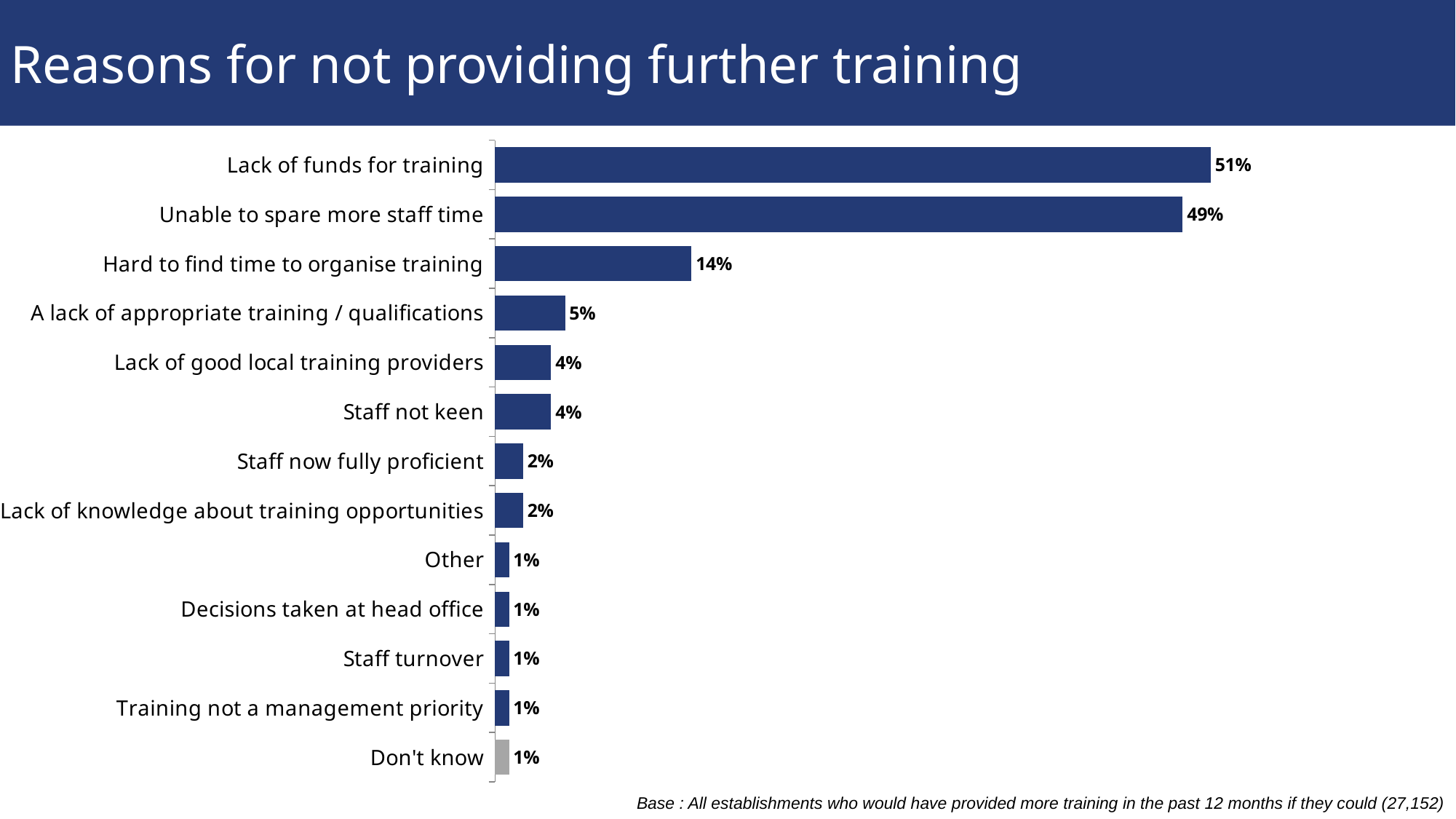
What is the value for Hard to find time to organise training? 14% Which is larger, A lack of appropriate training / qualifications or Lack of good local training providers? A lack of appropriate training / qualifications Which bar is shown in grey rather than dark blue? Don't know What is the title of the slide? Reasons for not providing further training What is the value for Staff not keen? 4% What is the difference between Lack of funds for training and Unable to spare more staff time? 2% What is the difference between Unable to spare more staff time and Hard to find time to organise training? 35% How many reasons are listed in the chart? 13 Which reason has the highest value? Lack of funds for training What kind of chart is shown on the slide? Bar chart What is the value for Lack of funds for training? 51% What is the value for Staff now fully proficient? 2%